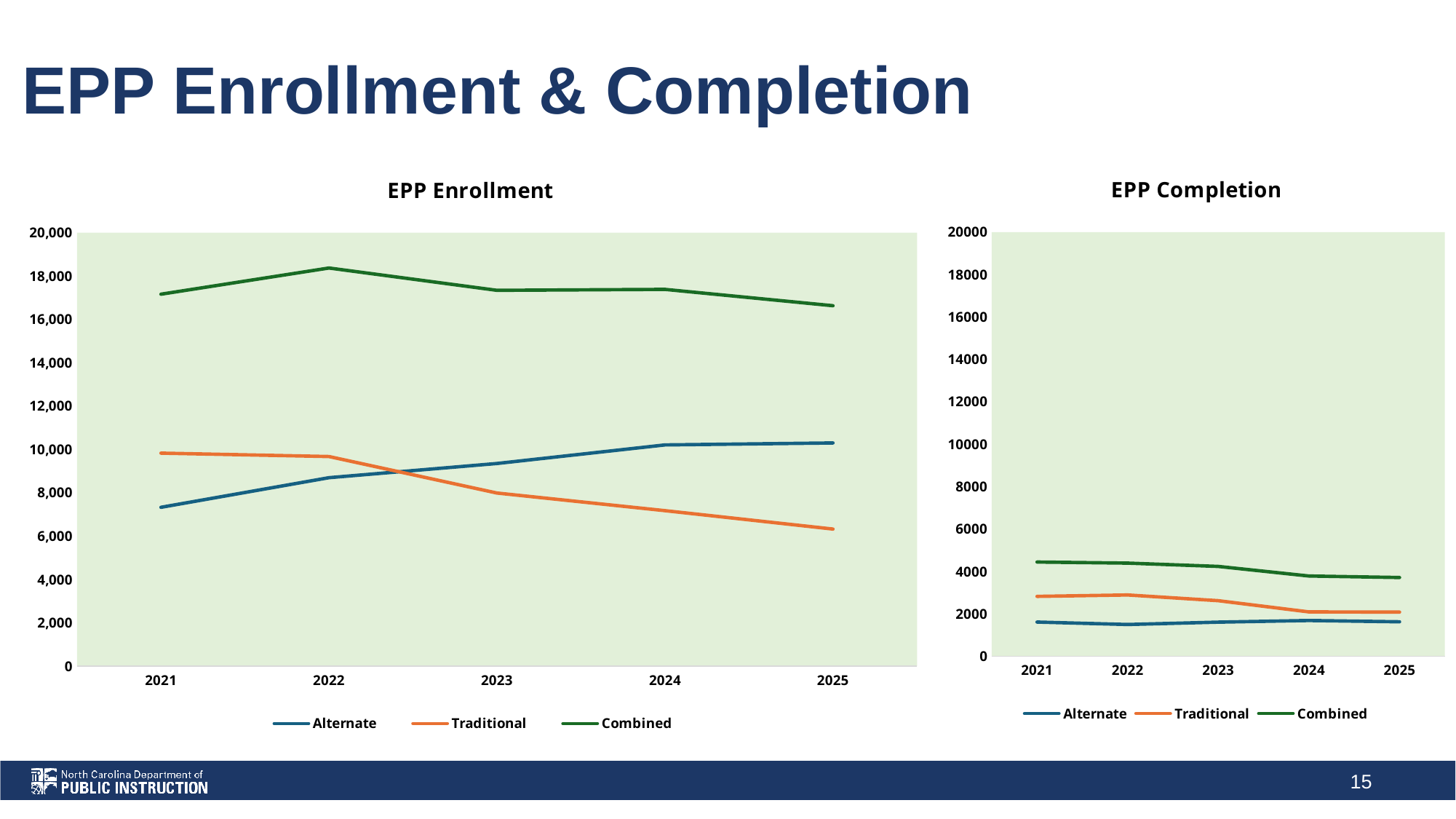
How many years are shown on the x axis of the EPP Enrollment chart? 5 In the EPP Enrollment chart, is the Combined value for 2025 greater or less than 18,000? less In the EPP Enrollment chart, does the Alternate series rise or fall from 2021 to 2025? rise How many series does the legend of the EPP Completion chart list? 3 In the EPP Enrollment chart, which colour is used for the Traditional series? orange In the EPP Completion chart, which series is lowest in 2021? Alternate In the EPP Enrollment chart, which is larger in 2025, Alternate or Traditional? Alternate In the EPP Enrollment chart, which series is highest across all years? Combined In the EPP Completion chart, is the Combined value for 2021 greater or less than 4000? greater What kind of chart is the EPP Enrollment chart? line chart In the EPP Enrollment chart, which is larger in 2021, Alternate or Traditional? Traditional In the EPP Enrollment chart, does the Traditional series rise or fall from 2021 to 2025? fall